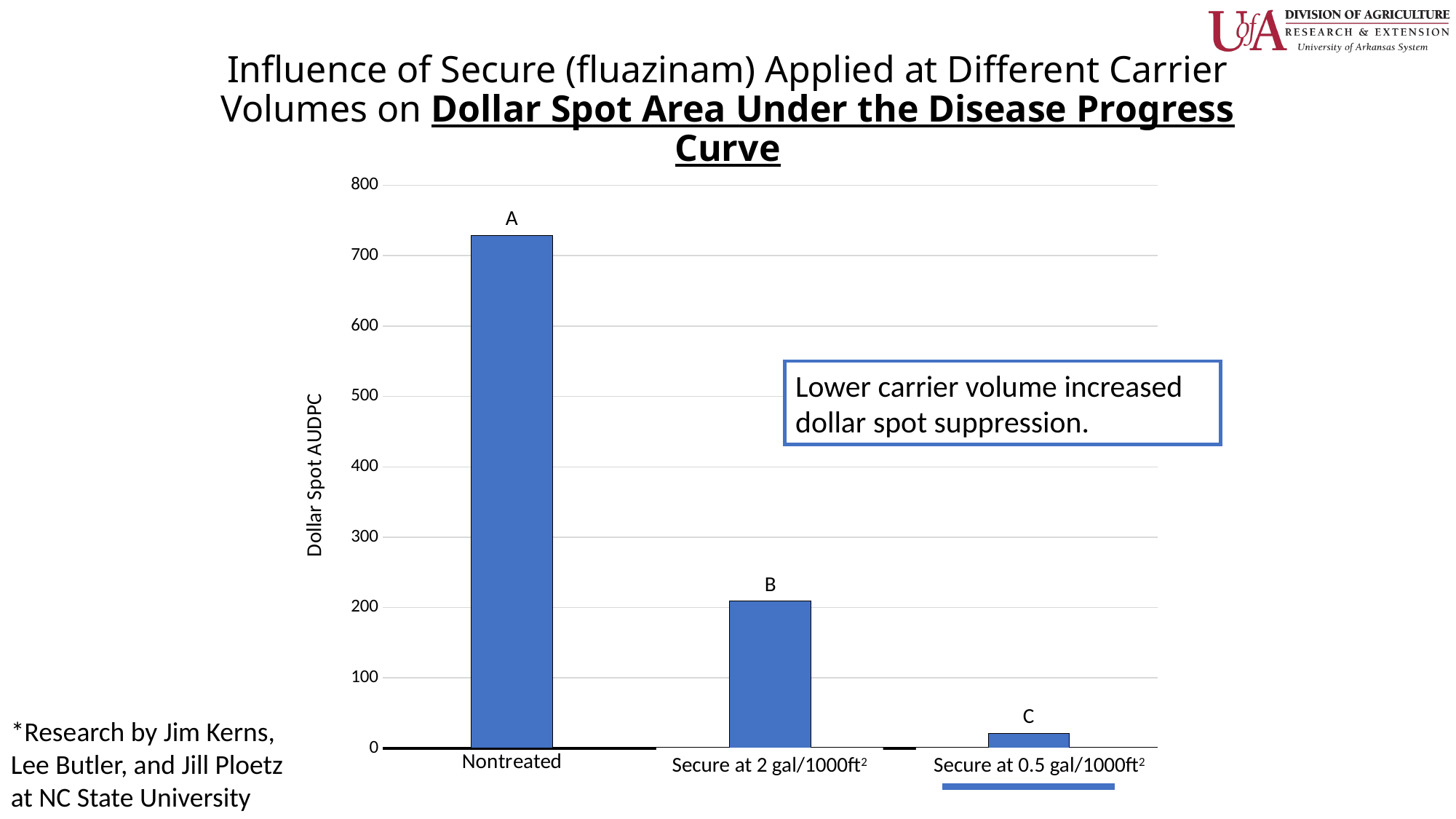
Do the bar values rise or fall from left to right across the categories? fall What letter is printed above the bar for Secure at 2 gal/1000ft²? B Is the value for Nontreated greater or less than 700? greater Which category has the lowest Dollar Spot AUDPC? Secure at 0.5 gal/1000ft² Which category has the highest Dollar Spot AUDPC? Nontreated Which has a larger Dollar Spot AUDPC, Secure at 2 gal/1000ft² or Secure at 0.5 gal/1000ft²? Secure at 2 gal/1000ft² How many categories (bars) are plotted in the chart? 3 What is the label on the vertical axis of the chart? Dollar Spot AUDPC What kind of chart is shown on the slide? bar chart Is the value for Secure at 0.5 gal/1000ft² greater or less than 100? less Is the value for Secure at 2 gal/1000ft² greater or less than 300? less